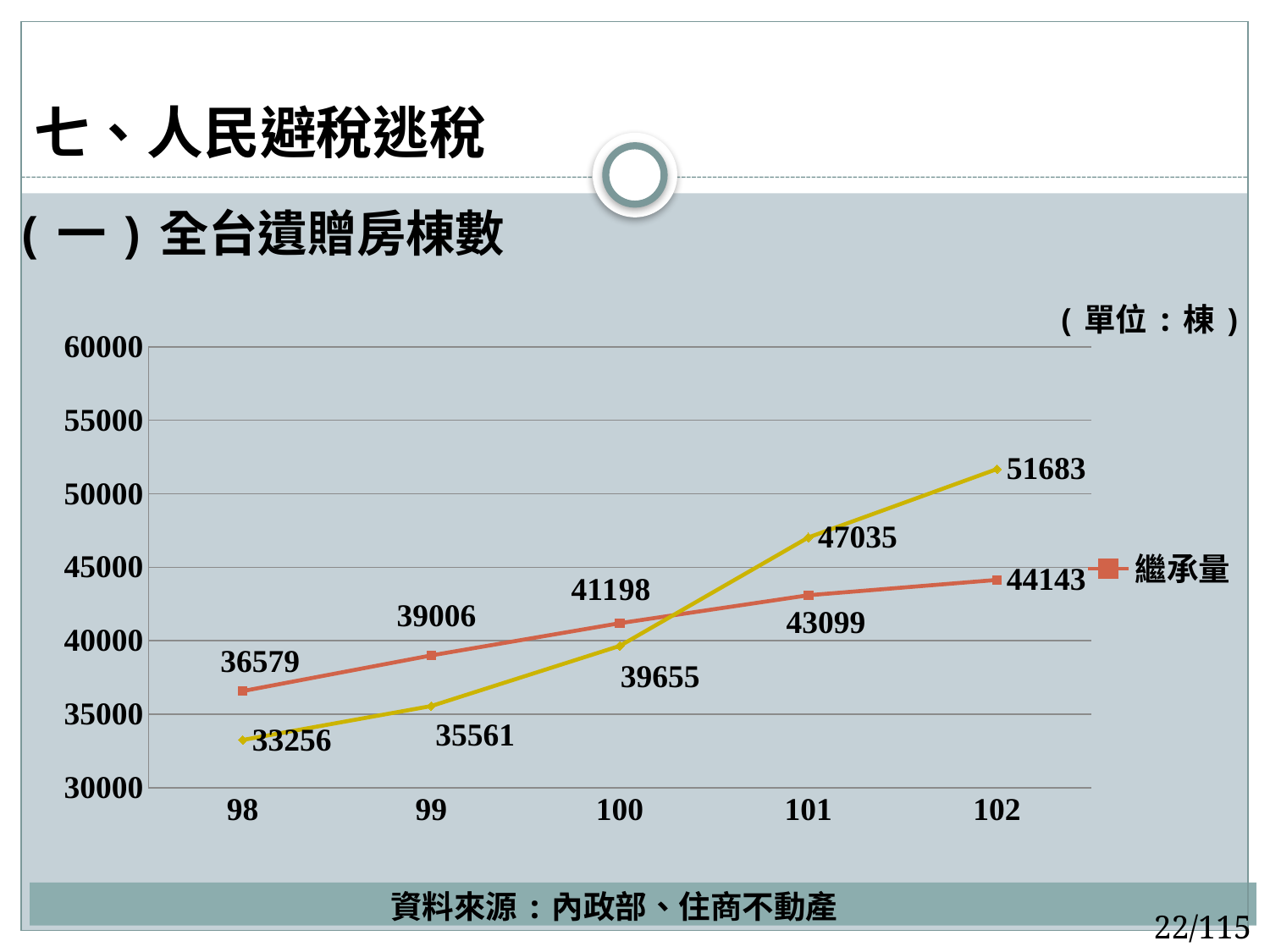
Does 繼承量 rise or fall from year 98 to year 102? rise What is the difference between 繼承量 in year 102 and in year 98? 7564 In which year is 繼承量 highest? 102 How many years are shown on the x axis? 5 What is the value of the yellow line for year 98? 33256 In year 99, which is larger: 繼承量 or the yellow line? 繼承量 What is the value of 繼承量 for year 100? 41198 What kind of chart is shown on the slide? line chart In which year is the yellow line lowest? 98 How much did the yellow line increase from year 101 to year 102? 4648 What is the value of 繼承量 for year 102? 44143 In year 101, which is larger: 繼承量 or the yellow line? the yellow line